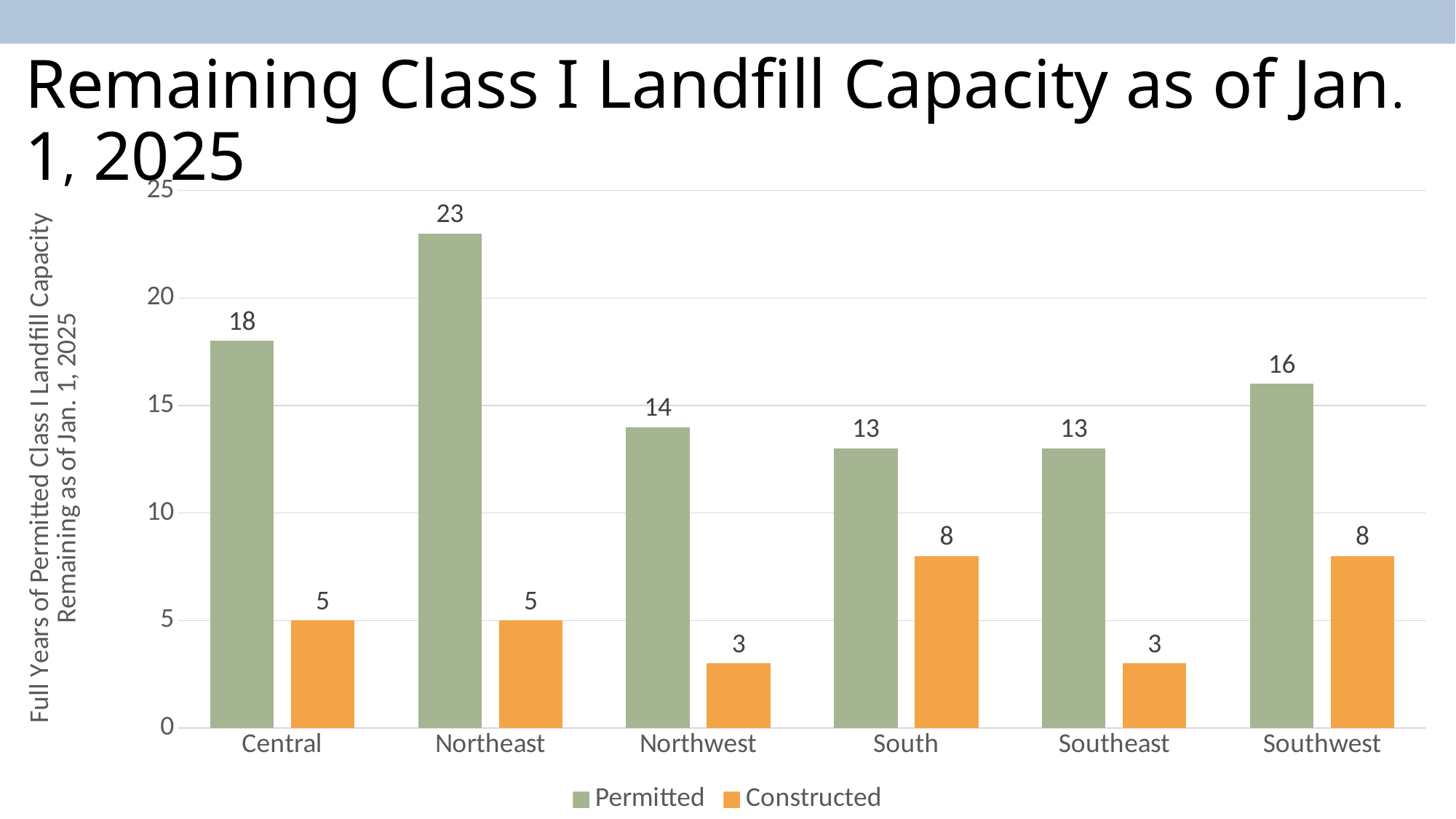
What is the title of the slide? Remaining Class I Landfill Capacity as of Jan. 1, 2025 What is the Permitted value for Northeast? 23 What is the Permitted value for Southwest? 16 How many regions are shown on the x axis? 6 How many series does the legend list? 2 Which is larger, the Constructed value for Northwest or the Constructed value for Southwest? Southwest Which region has the lowest Permitted value? South and Southeast What is the difference between the Permitted and Constructed values for Central? 13 What is the Constructed value for South? 8 Which region has the highest Permitted value? Northeast What is the difference between the Permitted values for Northeast and Northwest? 9 What kind of chart is shown on the slide? Bar chart